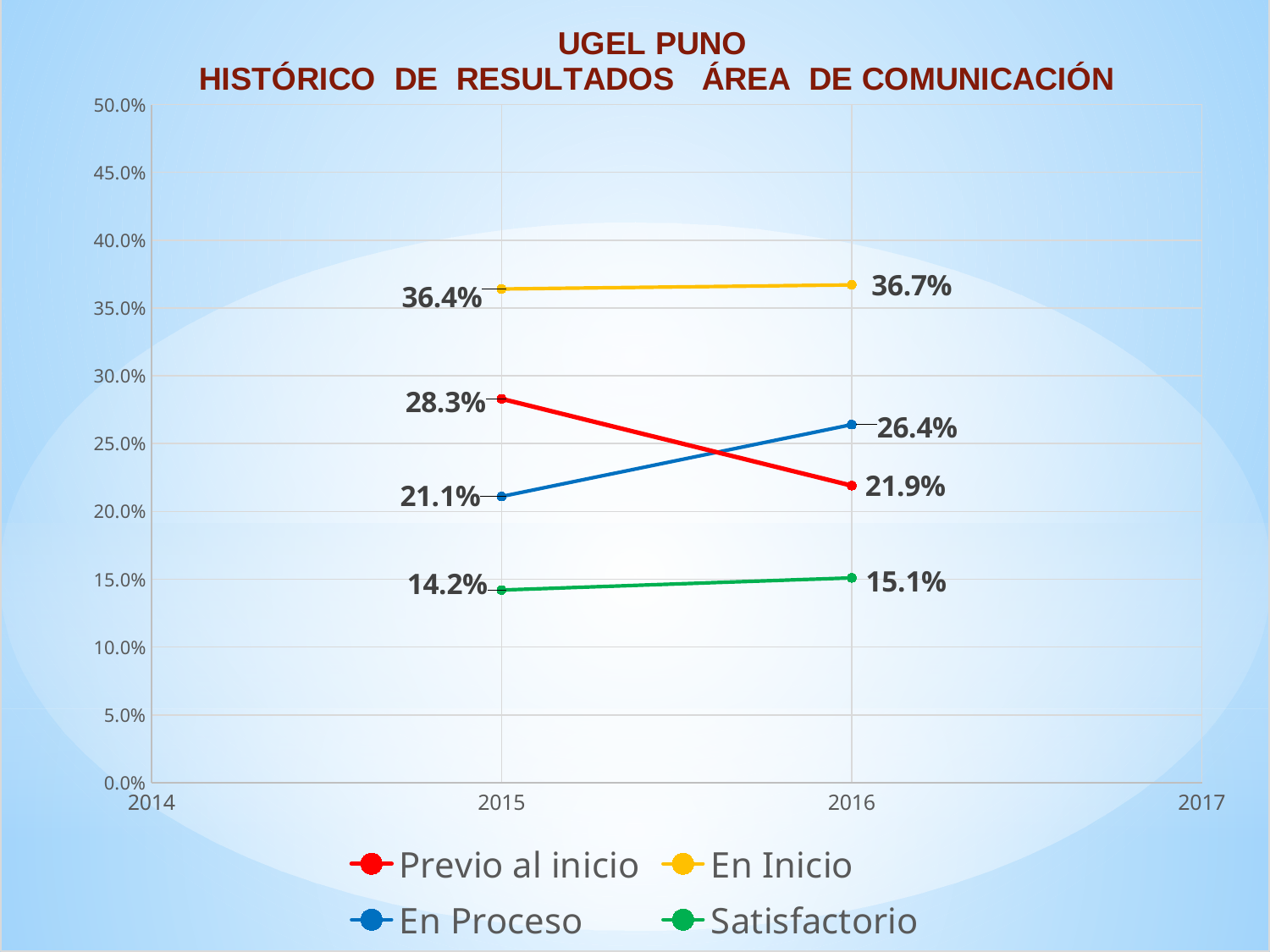
What kind of chart is shown on the slide? line chart How many series does the legend list? 4 Which series has the highest value in 2016? En Inicio What is the difference between the Previo al inicio values in 2015 and 2016? 6.4% Does the Previo al inicio series rise or fall from 2015 to 2016? fall What is the value for En Proceso in 2016? 26.4% What is the value for En Inicio in 2015? 36.4% Which series has the lowest value in 2015? Satisfactorio Which is larger in 2016, En Proceso or Previo al inicio? En Proceso What is the value for Satisfactorio in 2015? 14.2% What colour is the line for Satisfactorio? green What is the value for Previo al inicio in 2016? 21.9%